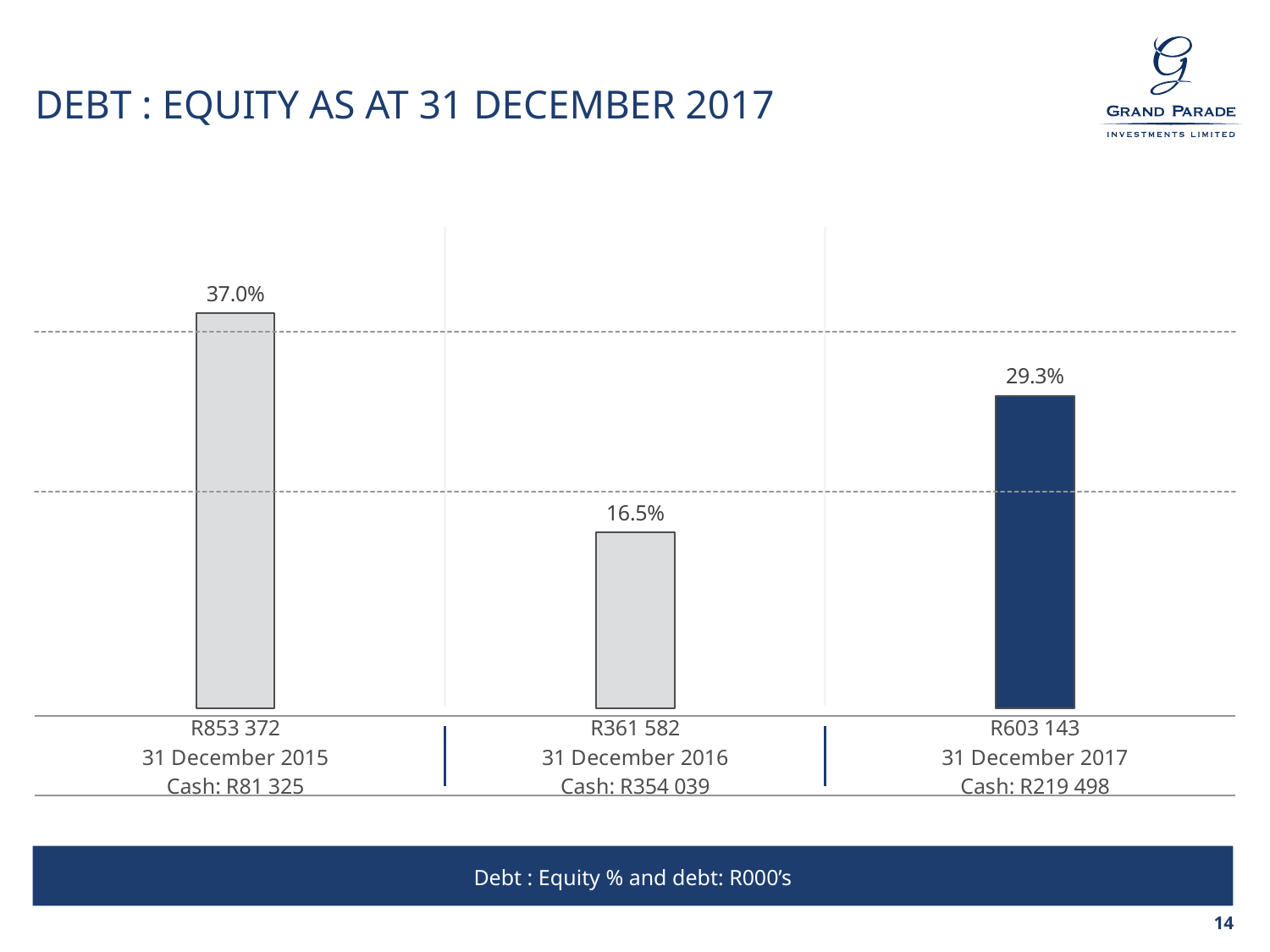
Is the debt : equity percentage higher for 31 December 2016 or 31 December 2017? 31 December 2017 Which date has the lowest debt : equity percentage? 31 December 2016 What is the debt : equity percentage for 31 December 2017? 29.3% What is the debt : equity percentage for 31 December 2016? 16.5% What is the difference in debt : equity percentage between 31 December 2015 and 31 December 2017? 7.7% What is the difference in debt : equity percentage between 31 December 2017 and 31 December 2016? 12.8% What kind of chart is shown on the slide? Bar chart Which date has the highest debt : equity percentage? 31 December 2015 How many dates are shown on the chart? 3 What is the cash figure shown for 31 December 2016? R354 039 What is the debt : equity percentage for 31 December 2015? 37.0% What is the debt figure shown for 31 December 2017? R603 143